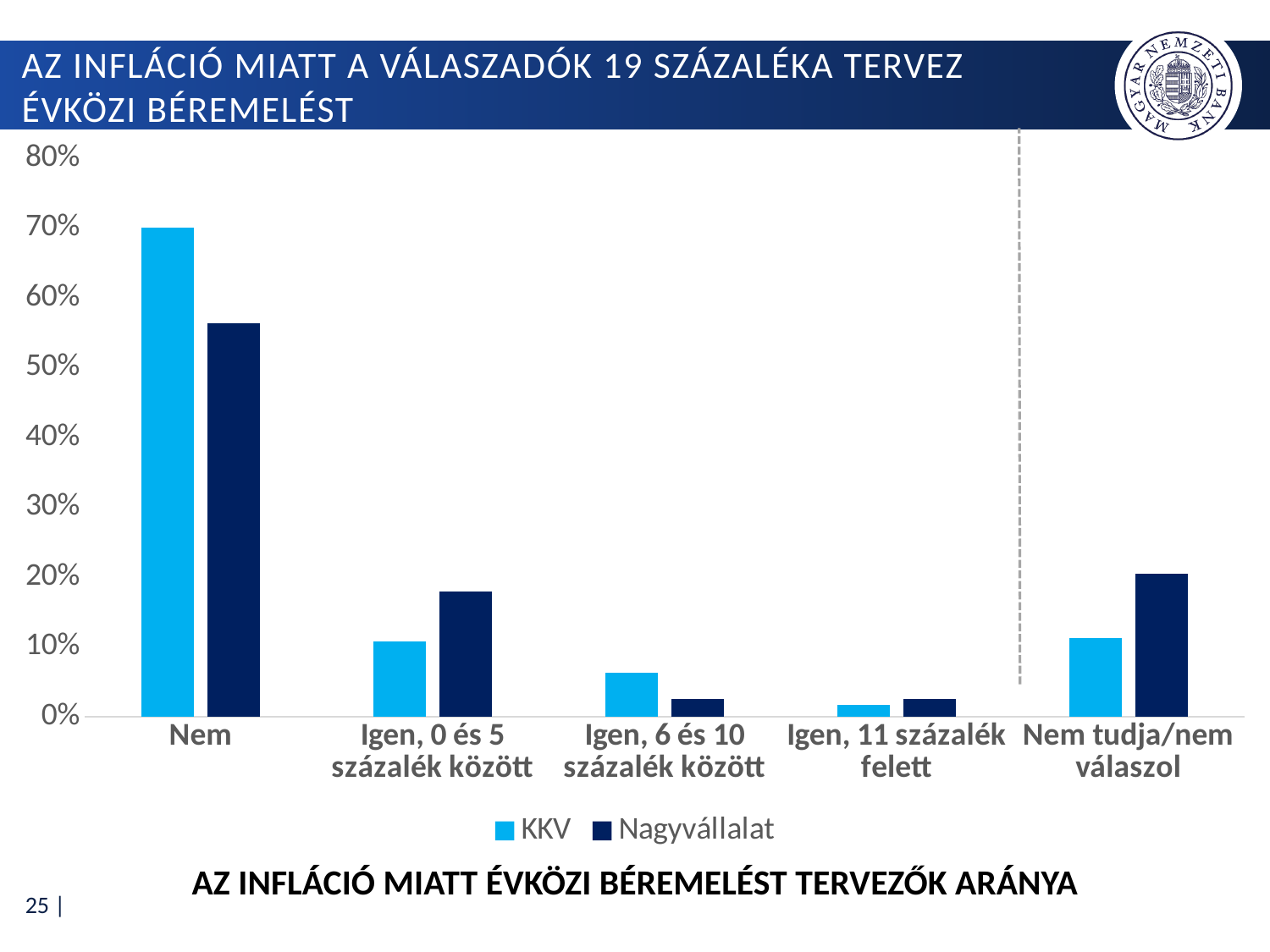
How many series does the legend list? 2 Is the Nagyvállalat value for Igen, 0 és 5 százalék között greater or less than 20%? less For the category Nem tudja/nem válaszol, which series has the larger value, KKV or Nagyvállalat? Nagyvállalat Is the Nagyvállalat value for Nem greater or less than 60%? less Which category has the highest value for the Nagyvállalat series? Nem Which category has the highest value for the KKV series? Nem Is the KKV value for Nem greater or less than 60%? greater Which category has the lowest value for the KKV series? Igen, 11 százalék felett What kind of chart is shown on the slide? bar chart For the category Igen, 6 és 10 százalék között, which series has the larger value, KKV or Nagyvállalat? KKV What are the two series named in the legend? KKV and Nagyvállalat How many categories are shown on the x axis of the chart? 5